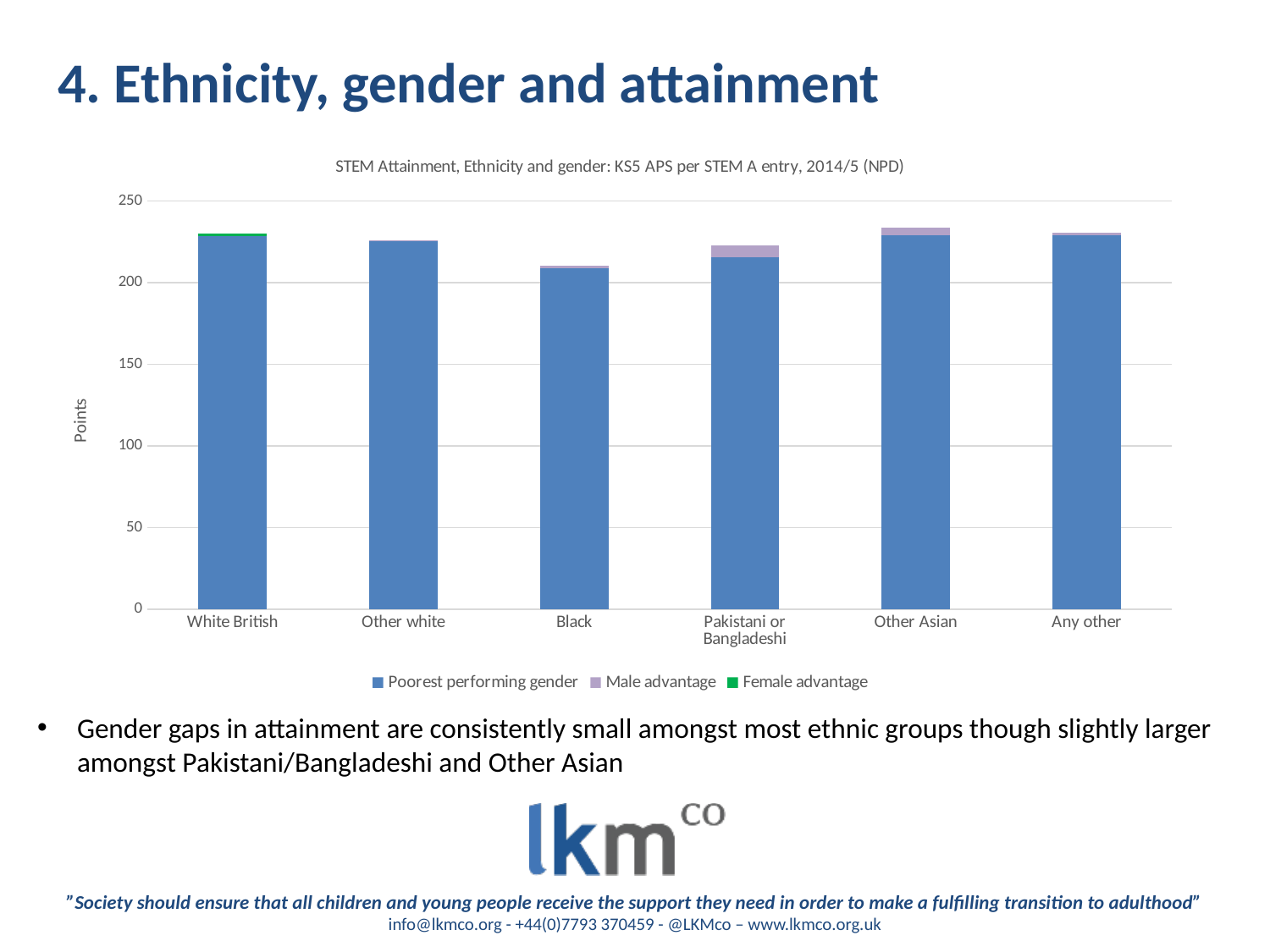
Which has the larger total bar, Black or Pakistani or Bangladeshi? Pakistani or Bangladeshi Is the total bar for Other white greater or less than 200? greater What kind of chart is shown on the slide? Stacked bar chart Is the total bar for Other Asian greater or less than 250? less Which ethnic group has the lowest total bar? Black Is the total bar for Black greater or less than 200? greater How many ethnic group categories are shown on the x axis? 6 Which series in the legend is shown in green? Female advantage Which has the larger total bar, Black or Other white? Other white What is the label on the y axis of the chart? Points How many series does the legend list? 3